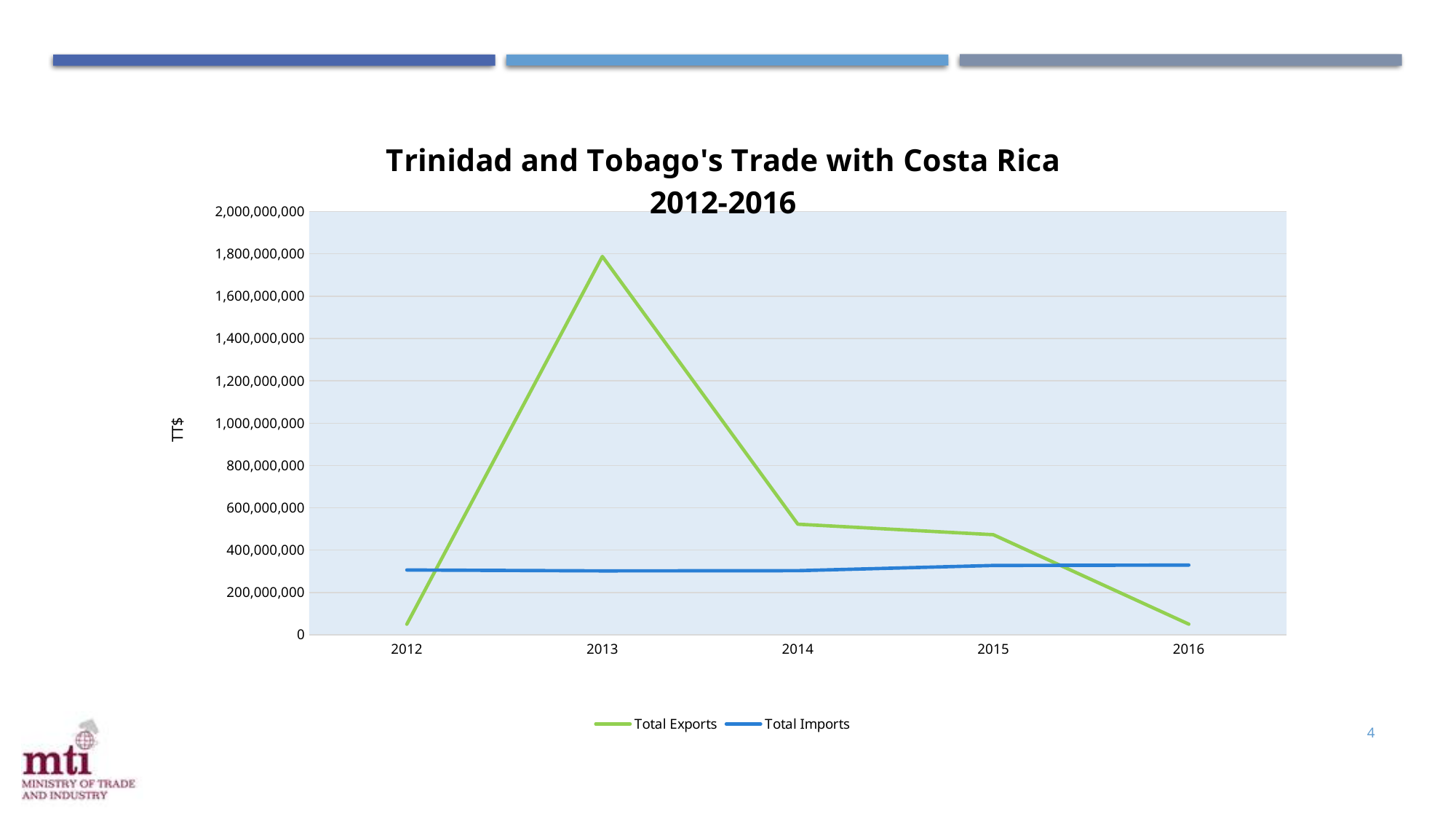
How many years are plotted on the x axis? 5 Is the value for Total Exports in 2014 greater or less than 400,000,000? greater In 2016, which is larger: Total Exports or Total Imports? Total Imports In 2013, which is larger: Total Exports or Total Imports? Total Exports Is the value for Total Exports in 2013 greater or less than 1,600,000,000? greater Do Total Exports rise or fall from 2013 to 2016? Fall Is the value for Total Exports in 2016 greater or less than 200,000,000? less In which year were Total Exports highest? 2013 What kind of chart is shown on the slide? Line chart What is the title of the chart? Trinidad and Tobago's Trade with Costa Rica 2012-2016 How many series does the legend list? 2